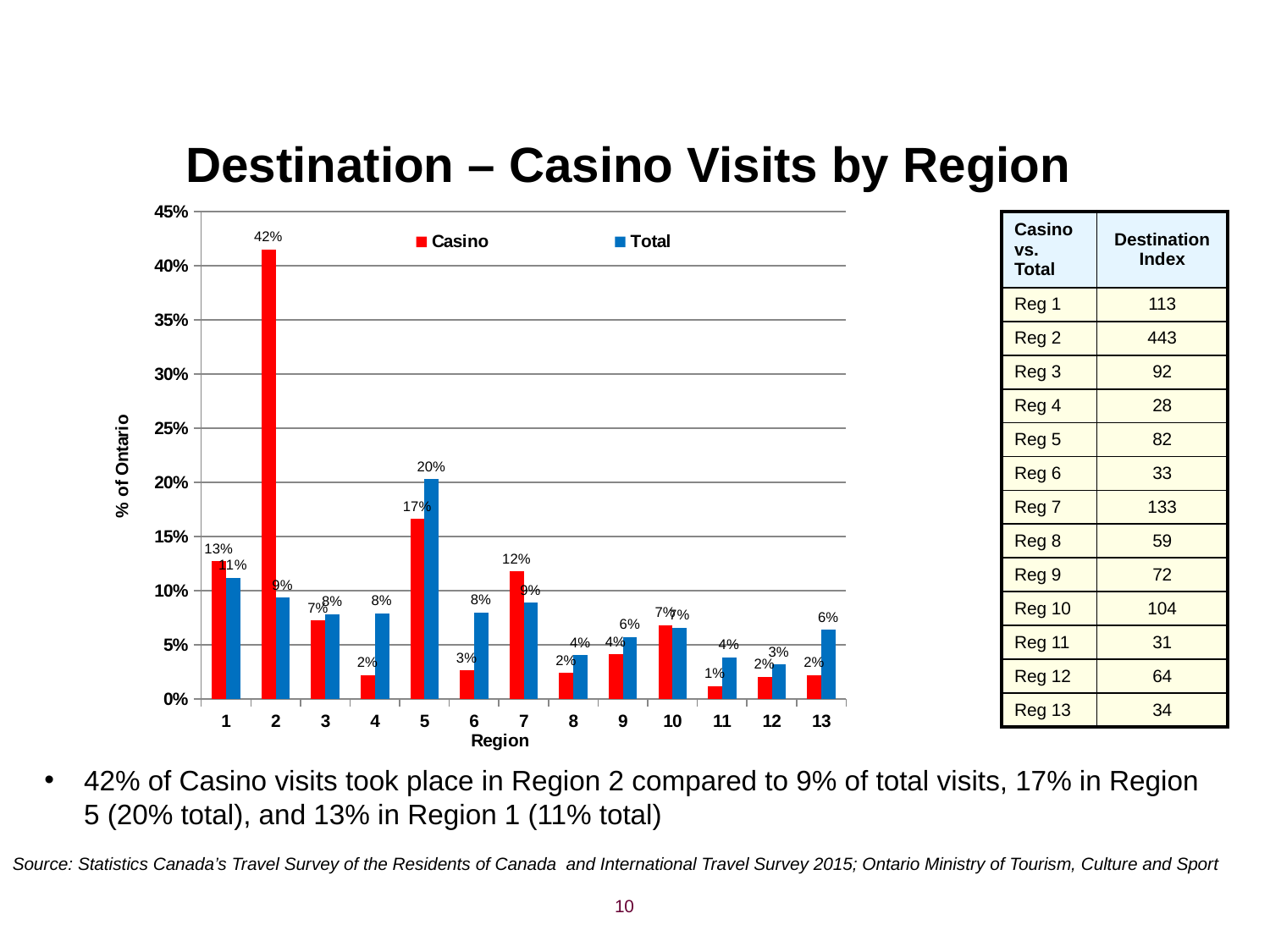
How many series does the chart legend list? 2 What is the Total value for Region 5? 20% Which region has the lowest Casino value? Region 11 What is the difference between the Casino and Total values for Region 2? 33 percentage points What type of chart is used to show Casino visits by region? Bar chart What percentage of Casino visits took place in Region 2? 42% What is the Casino value for Region 7? 12% Which region has the highest Casino value? Region 2 Is the Casino value for Region 2 greater or less than 40%? greater How many regions are shown on the x axis of the chart? 13 Which region has the highest Total value? Region 5 In Region 4, which is larger, the Casino value or the Total value? Total